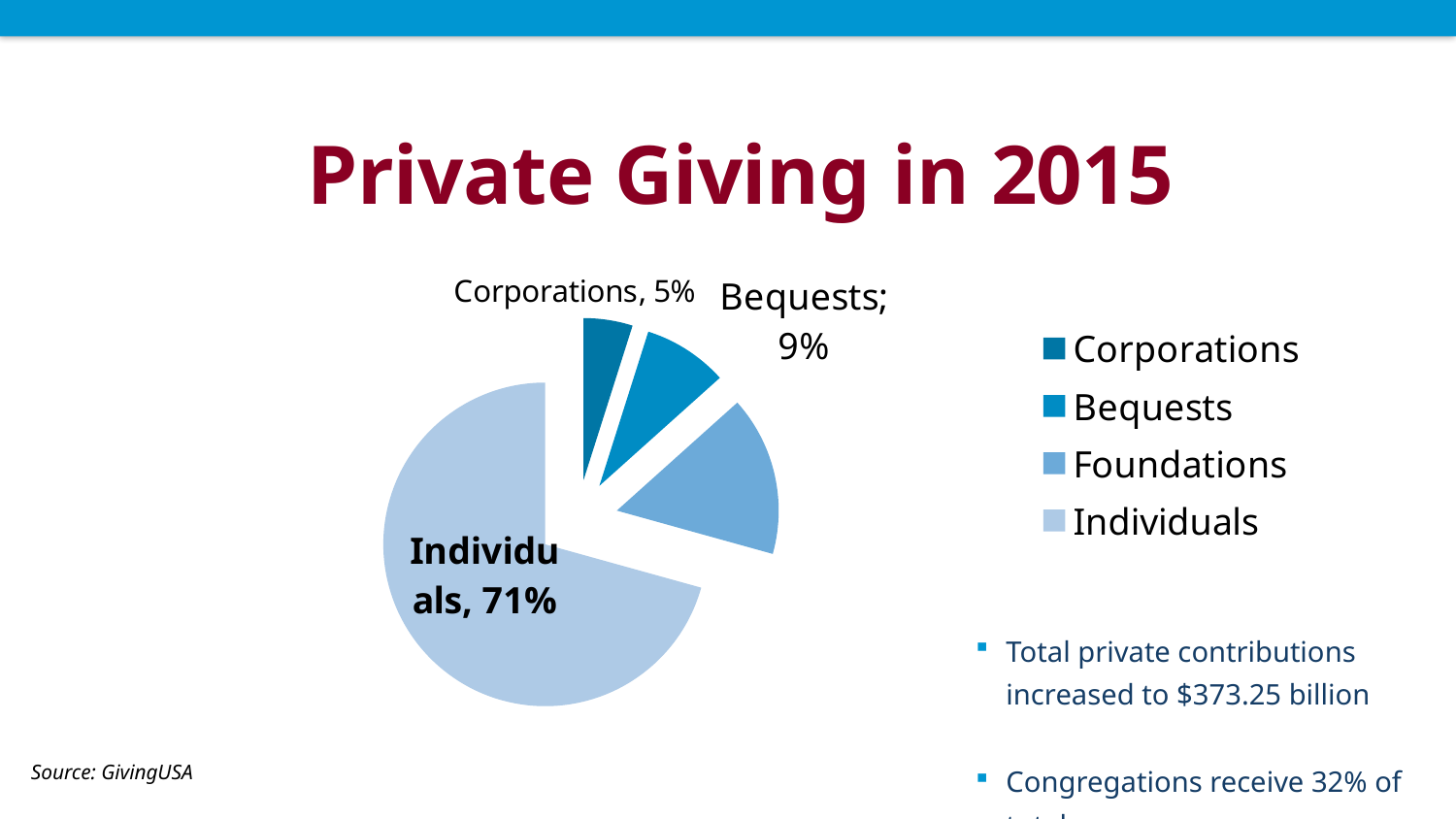
What percentage of the pie is labelled for Bequests? 9% What percentage of the pie is labelled for Corporations? 5% Which slice is larger, Bequests or Corporations? Bequests Which category has the largest slice of the pie? Individuals How many categories does the pie chart show? 4 What type of chart is shown on the slide? Pie chart Which category has the smallest slice of the pie? Corporations What is the title of the slide containing the chart? Private Giving in 2015 What share of private giving in 2015 came from Individuals? 71% Which slice is larger, Foundations or Corporations? Foundations How many entries does the legend list? 4 By how many percentage points does the Individuals share exceed the Bequests share? 62 percentage points